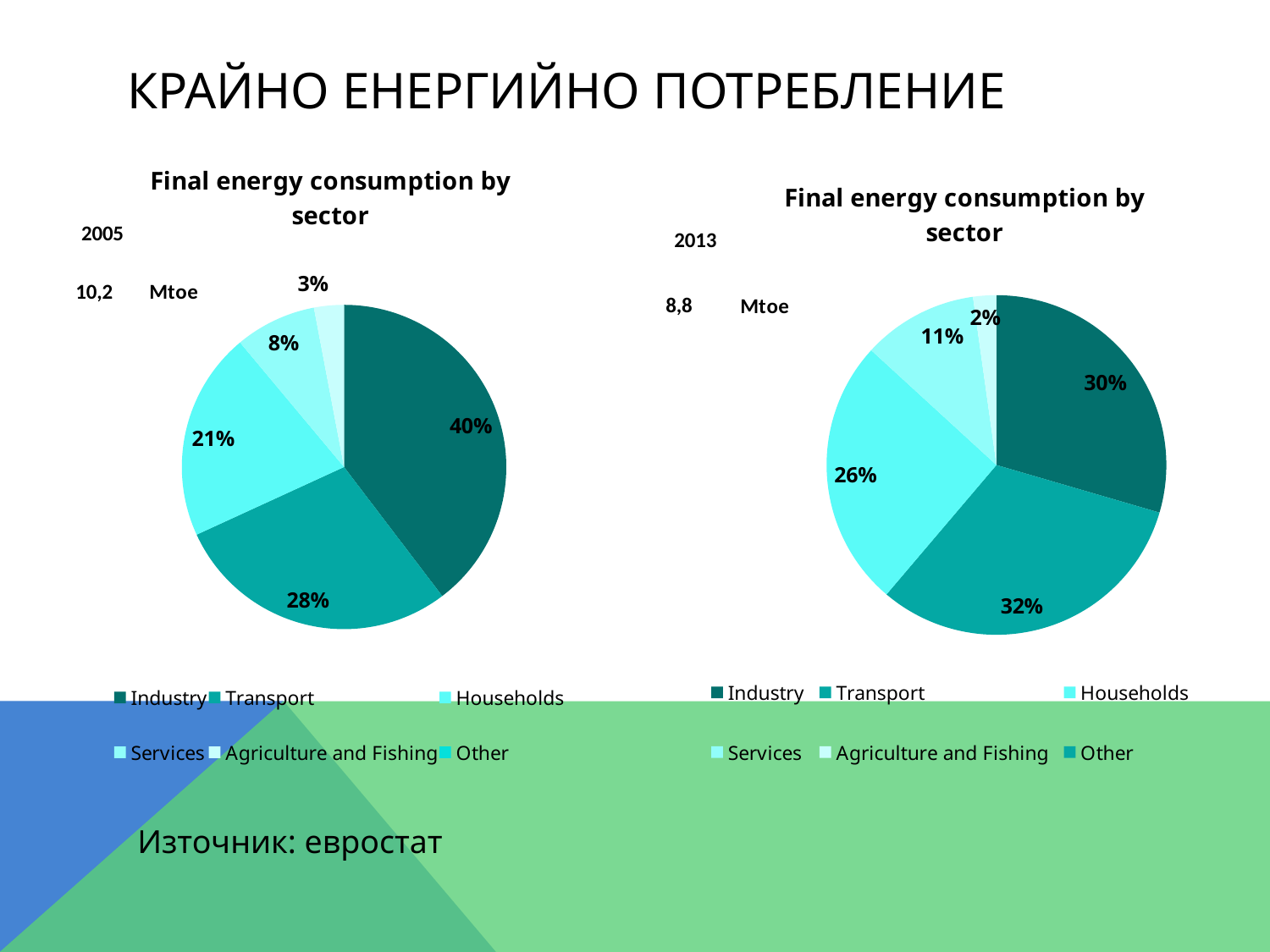
In the left pie chart (2005), what share does Industry have? 40% In the right pie chart (2013), which sector has the largest share? Transport What total consumption in Mtoe is shown next to the right pie chart (2013)? 8,8 Mtoe In the right pie chart (2013), what share does Households have? 26% In the right pie chart (2013), what share does Transport have? 32% How many entries does the legend of the right pie chart (2013) list? 6 In the left pie chart (2005), which sector has the largest share? Industry What type of chart is used on the left side of the slide? Pie chart In the left pie chart (2005), which labelled sector has the smallest share? Agriculture and Fishing In the right pie chart (2013), what is the difference between the Transport and Industry shares? 2% In the left pie chart (2005), which is larger, Households or Services? Households In the left pie chart (2005), what share does Transport have? 28%